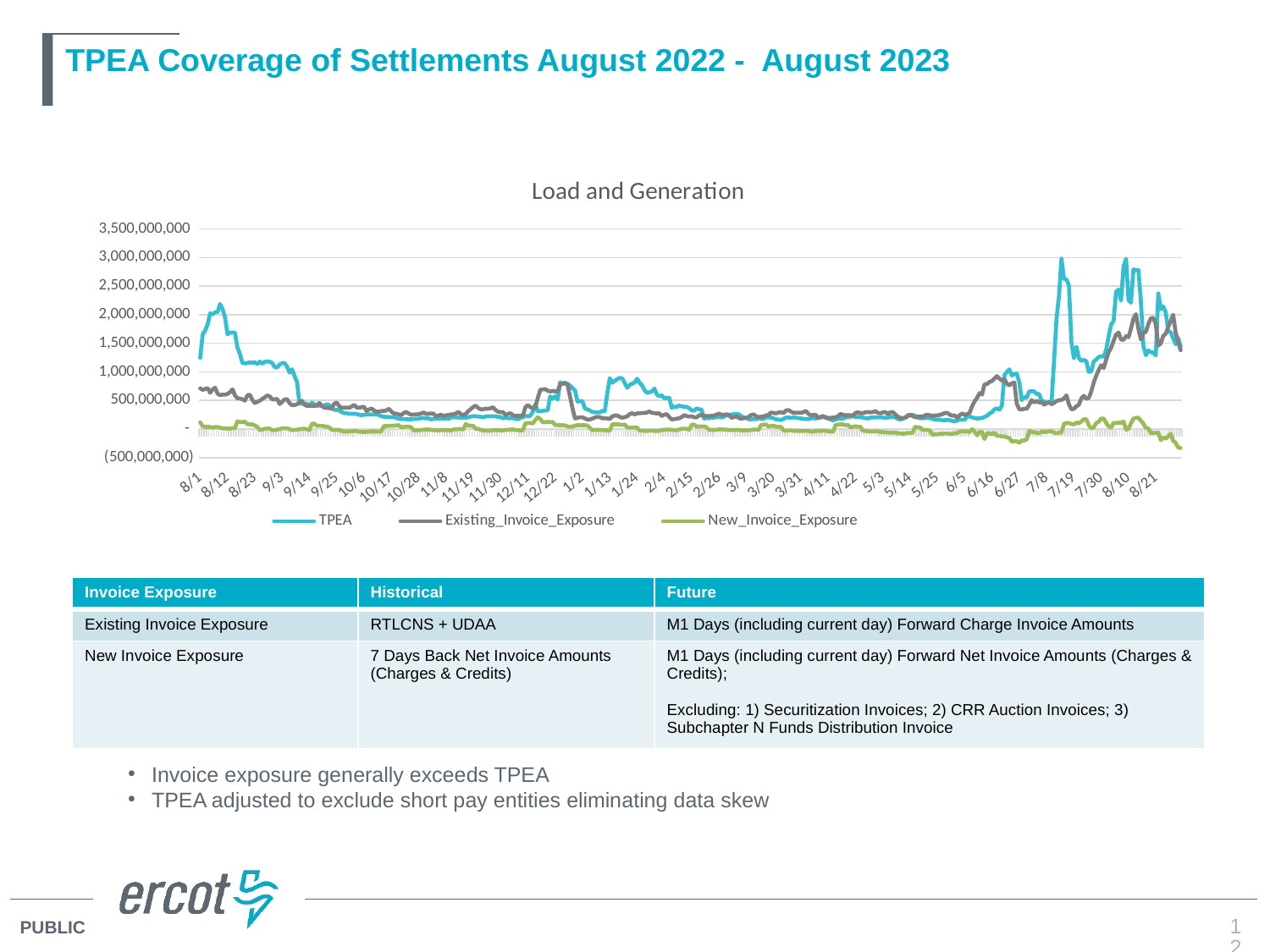
Around 7/19, which is larger: TPEA or Existing_Invoice_Exposure? TPEA Which series is lowest at the right end of the chart (around 8/21)? New_Invoice_Exposure Is the peak value of TPEA around 7/19 greater or less than 2,500,000,000? greater Which colour is used for the TPEA line in the chart? Blue What kind of chart is shown on the slide? Line chart Does the TPEA line rise or fall between 8/12 and 10/6? Fall How many series does the chart legend list? 3 Is the value of Existing_Invoice_Exposure around 3/9 greater or less than 500,000,000? less What is the title of the chart? Load and Generation Is the value of New_Invoice_Exposure around 1/2 greater or less than 500,000,000? less Which series reaches the highest peak on the chart? TPEA Does the Existing_Invoice_Exposure line rise or fall between 5/25 and 6/16? Rise